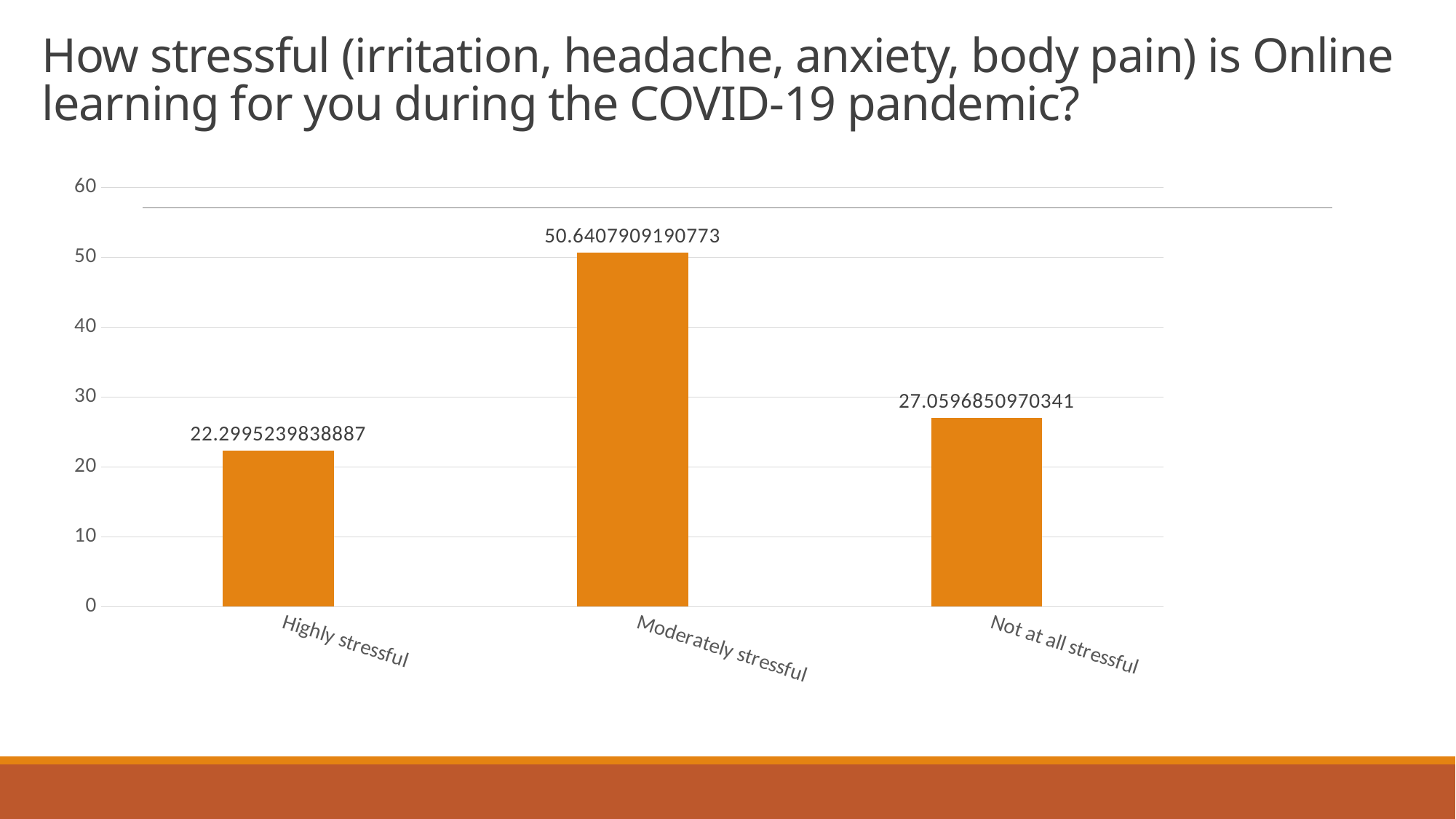
Which category has the highest value? Moderately stressful What is the difference between the values for Not at all stressful and Highly stressful? 4.7601611131454 How many categories are shown on the x axis? 3 What is the difference between the values for Moderately stressful and Highly stressful? 28.3412669351886 What is the value for Moderately stressful? 50.6407909190773 Is the value for Moderately stressful greater or less than 40? greater Which category has the lowest value? Highly stressful What is the value for Not at all stressful? 27.0596850970341 Is the value for Highly stressful greater or less than 30? less What is the value for Highly stressful? 22.2995239838887 What kind of chart is shown on the slide? bar chart Which is larger, the value for Not at all stressful or the value for Highly stressful? Not at all stressful